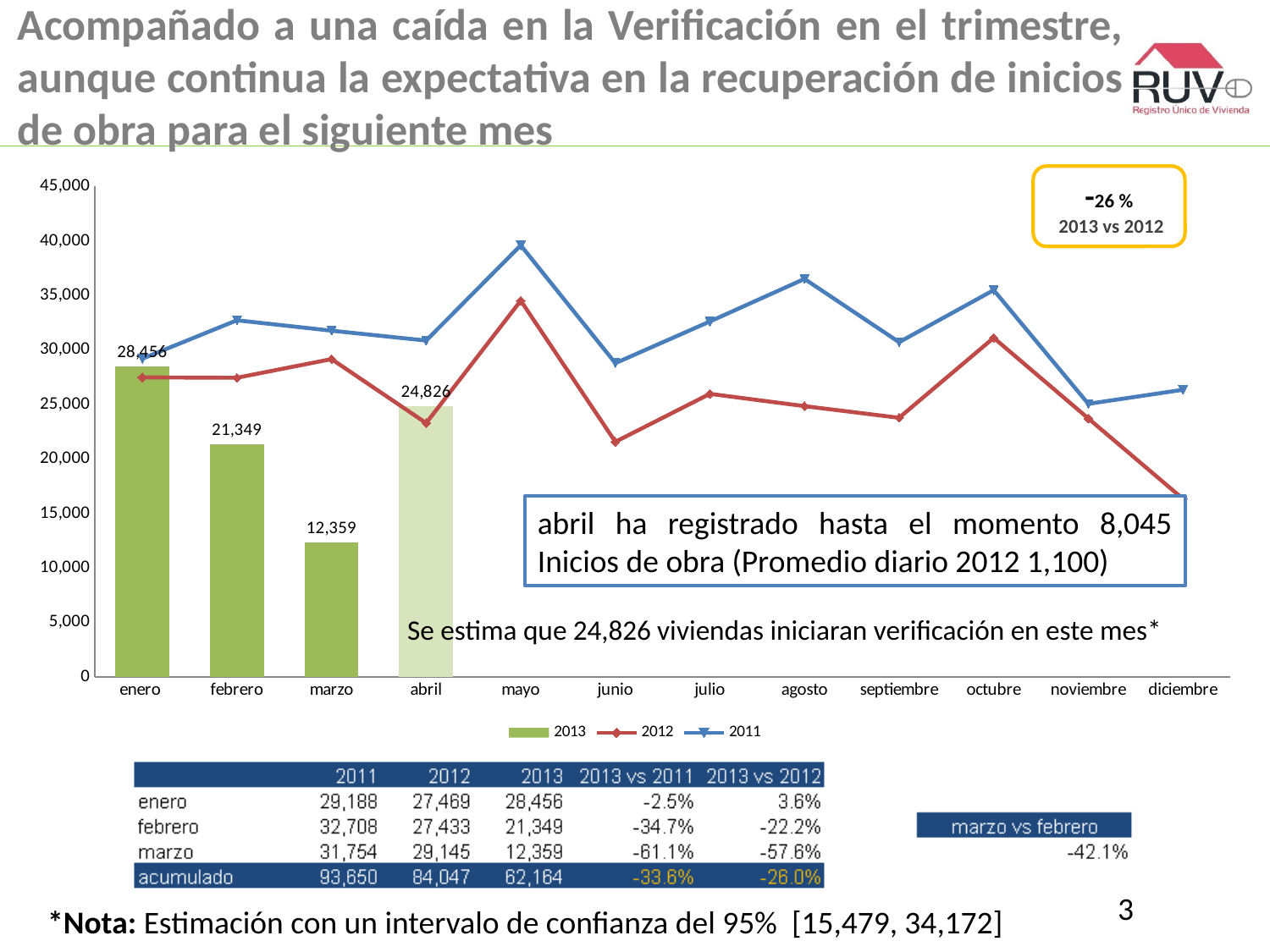
Is the 2011 value for mayo greater or less than 35,000? greater What is the difference between the 2013 values for enero and febrero? 7,107 What value is labelled on the lighter bar for abril? 24,826 In mayo, which series is higher, 2011 or 2012? 2011 What value is labelled on the 2013 bar for febrero? 21,349 Among the 2013 bars for enero, febrero and marzo, which month has the highest value? enero Among the 2013 bars for enero, febrero and marzo, which month has the lowest value? marzo How many series does the legend list? 3 Do the 2013 bars rise or fall from enero to marzo? fall How many months are shown on the x axis? 12 What value is labelled on the 2013 bar for enero? 28,456 What value is labelled on the 2013 bar for marzo? 12,359